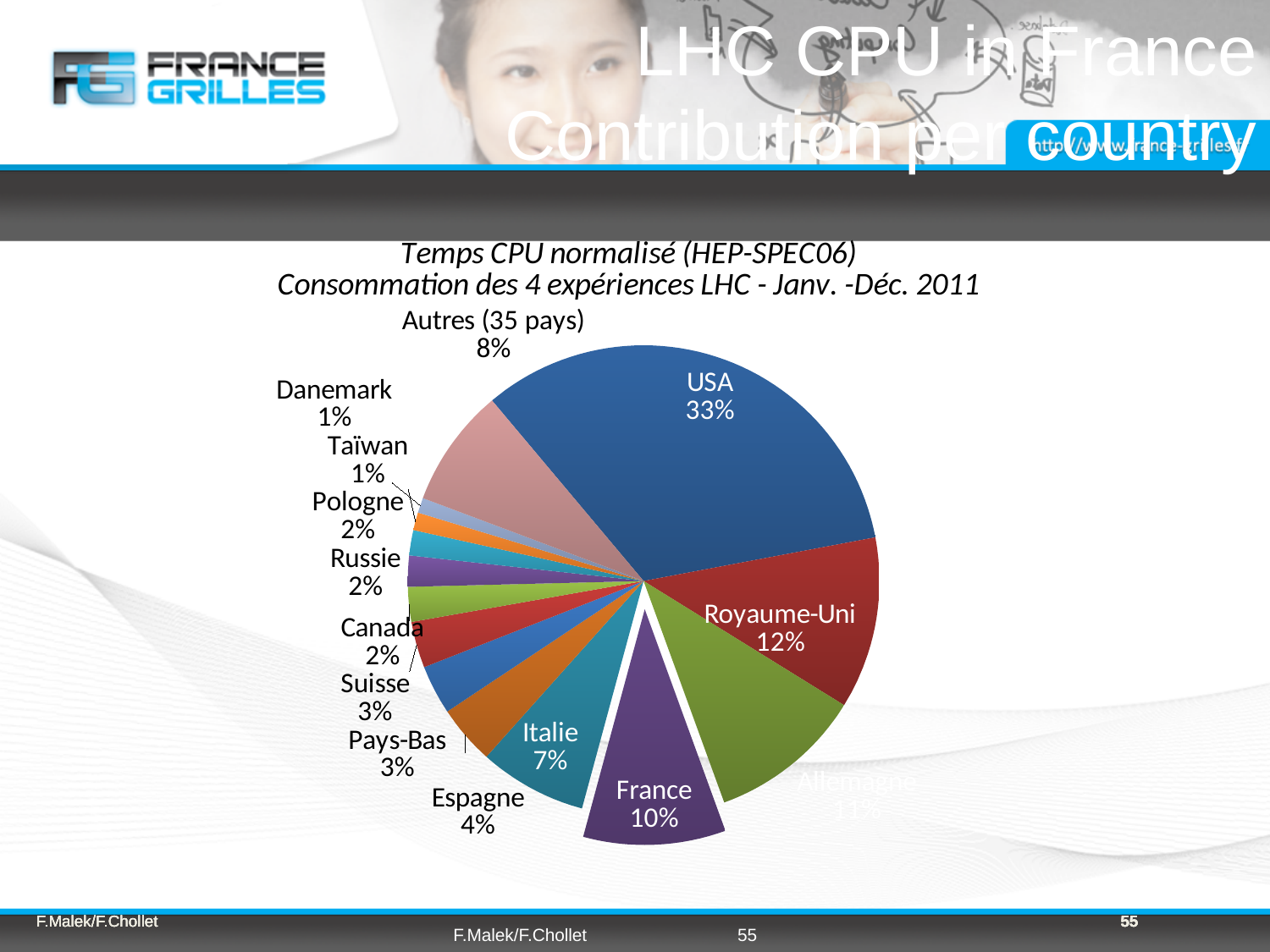
What period does the chart title say the data covers? Janv. -Déc. 2011 How many slices does the pie chart have? 14 What is the value shown for Italie? 7% What is the value shown for France? 10% Which is larger, the share for Espagne or the share for Italie? Italie What share of the pie does USA account for? 33% What is the difference between the USA share and the France share? 23% What kind of chart is shown on the slide? pie chart Which country has the largest slice of the pie? USA What is the difference between the Royaume-Uni share and the Italie share? 5% What is the value shown for Royaume-Uni? 12% What is the value shown for Autres (35 pays)? 8%